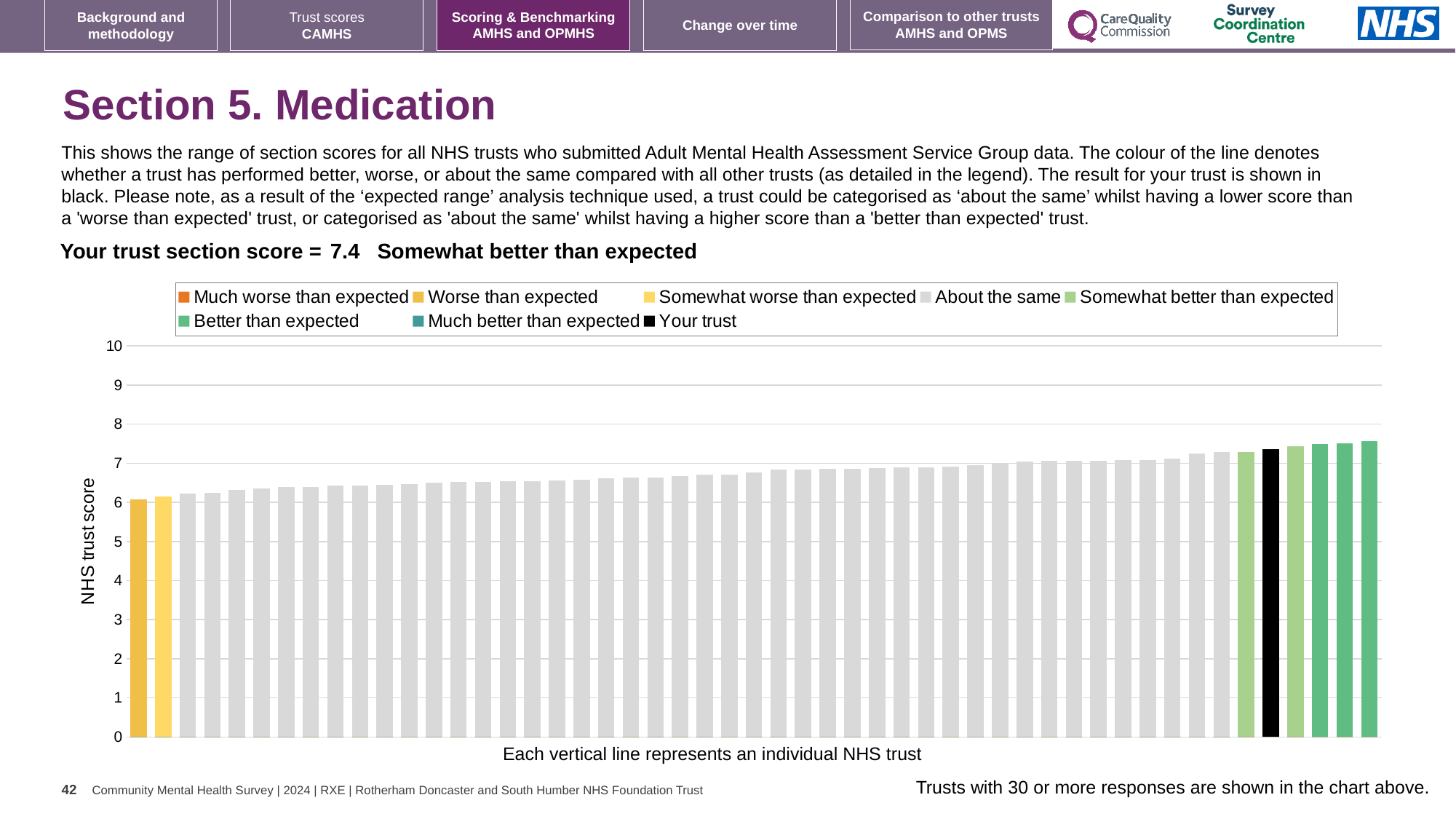
Is the value of the black bar (your trust) greater or less than 7? greater Is the value of the black bar (your trust) greater or less than 8? less How many entries does the chart legend list? 8 Is the value of the rightmost (highest) bar greater or less than 8? less Do the bar values rise or fall moving from left to right along the x axis? rise Which is larger: the value of the black bar (your trust) or the value of the leftmost bar? the black bar (your trust) What kind of chart is shown on the slide? bar chart Which expected-range category is your trust's section score placed in? Somewhat better than expected How many bars are coloured in the 'Better than expected' green to the right of the black bar? 3 What is the label on the vertical axis of the chart? NHS trust score What is the section score for your trust shown on the slide? 7.4